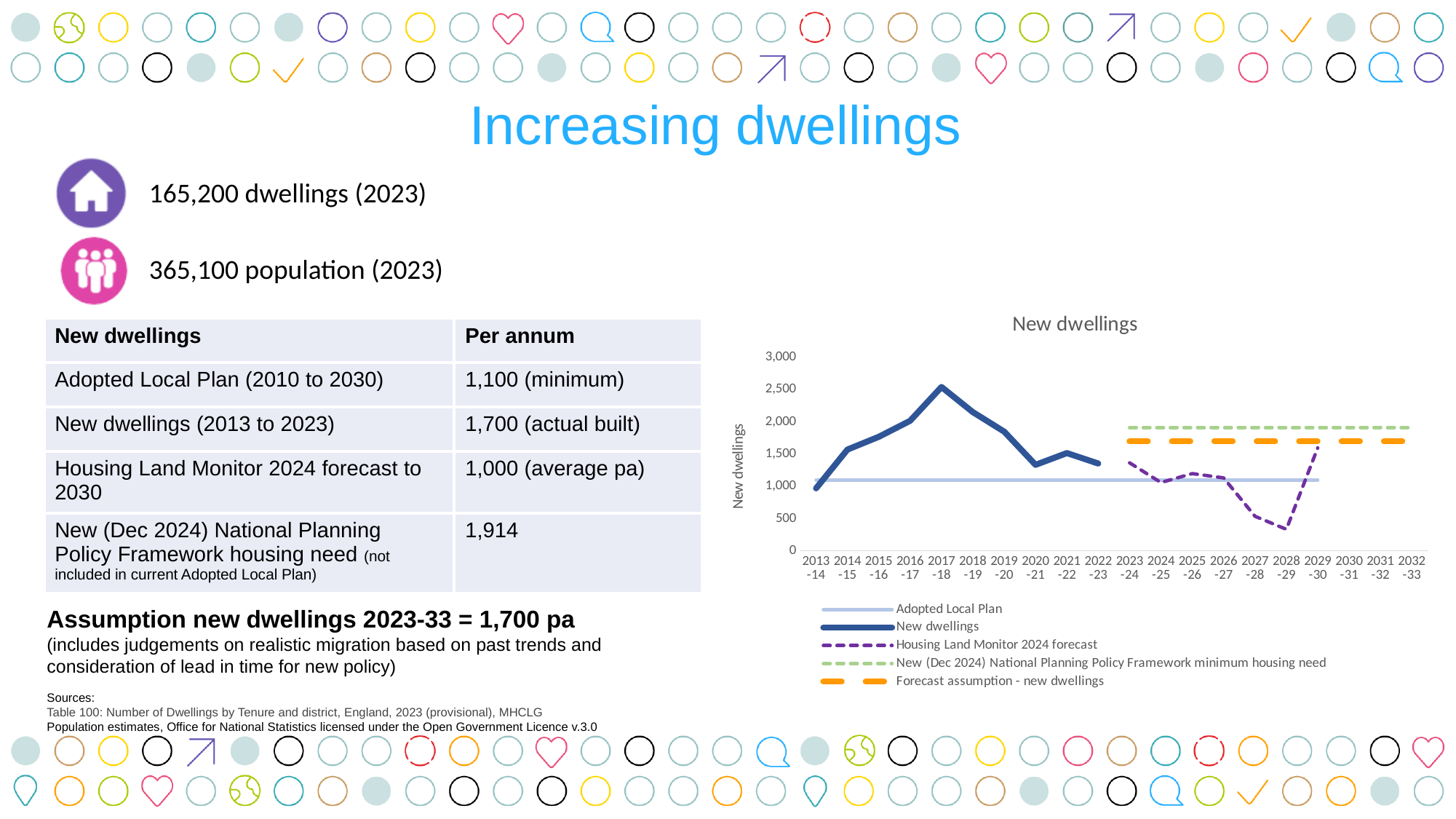
What kind of chart is shown on the slide? line chart In which year does the New dwellings series reach its highest value? 2017-18 Does the New dwellings series rise or fall between 2017-18 and 2020-21? fall How many year categories are shown on the x axis of the chart? 20 In which year does the Housing Land Monitor 2024 forecast series reach its lowest value? 2028-29 In which year is the New dwellings series at its lowest value? 2013-14 How many series does the chart legend list? 5 What is the title of the chart? New dwellings Which is higher on the chart: the New (Dec 2024) National Planning Policy Framework minimum housing need line or the Forecast assumption - new dwellings line? New (Dec 2024) National Planning Policy Framework minimum housing need Is the Housing Land Monitor 2024 forecast value in 2028-29 greater or less than 500? less Is the value of the New dwellings series in 2017-18 greater or less than 2,000? greater